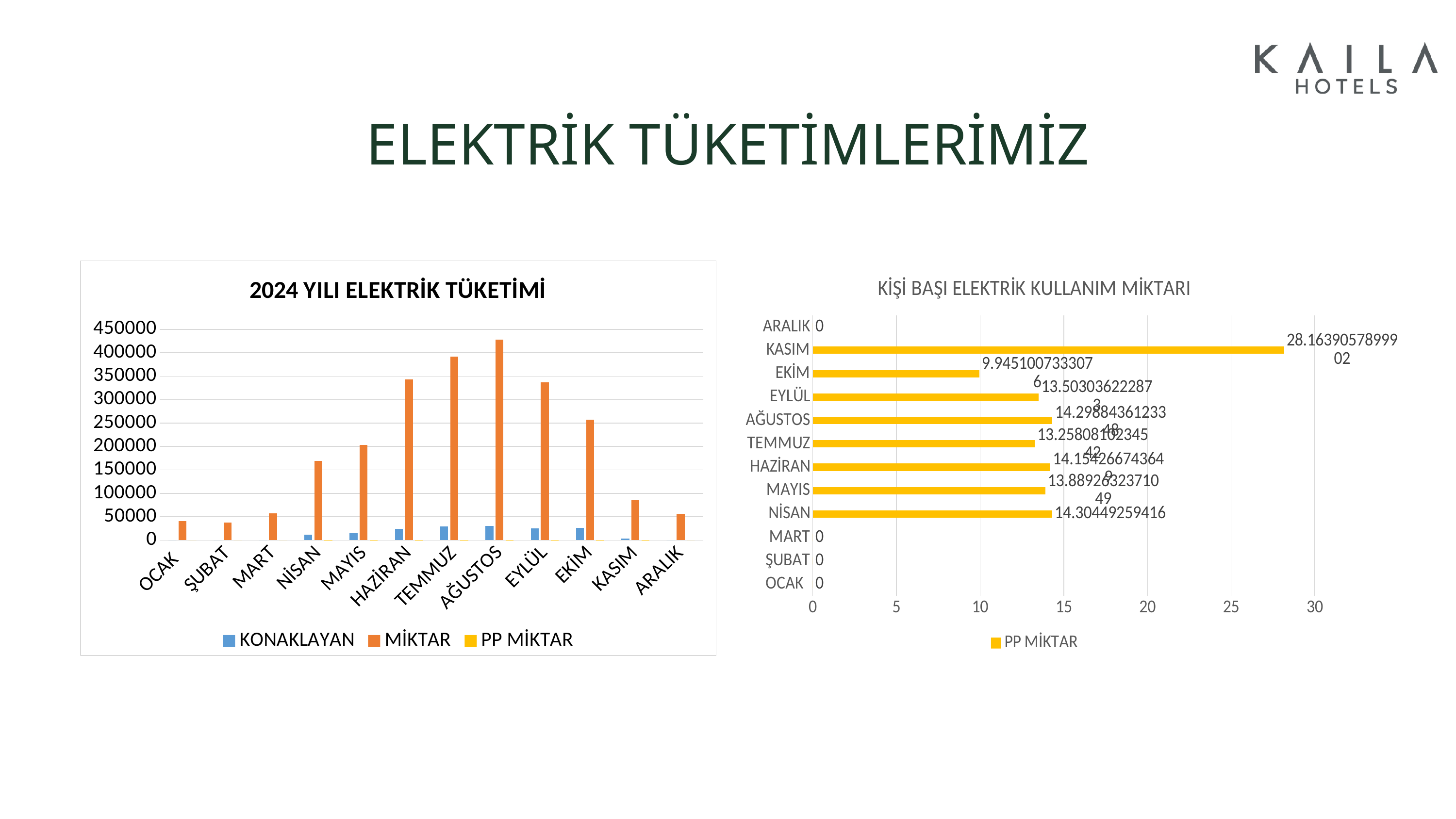
In the '2024 YILI ELEKTRİK TÜKETİMİ' chart, which month has the highest MİKTAR value? AĞUSTOS In the 'KİŞİ BAŞI ELEKTRİK KULLANIM MİKTARI' chart, which is larger, the value for KASIM or the value for EKİM? KASIM In the '2024 YILI ELEKTRİK TÜKETİMİ' chart, is the MİKTAR value for HAZİRAN greater or less than 300000? greater How many series does the legend of the '2024 YILI ELEKTRİK TÜKETİMİ' chart list? 3 In the 'KİŞİ BAŞI ELEKTRİK KULLANIM MİKTARI' chart, what is the PP MİKTAR value for ARALIK? 0 How many months are shown on the x axis of the '2024 YILI ELEKTRİK TÜKETİMİ' chart? 12 What kind of chart is the '2024 YILI ELEKTRİK TÜKETİMİ' chart on the left? bar chart In the '2024 YILI ELEKTRİK TÜKETİMİ' chart, does the MİKTAR series rise or fall from OCAK to AĞUSTOS? rise In the '2024 YILI ELEKTRİK TÜKETİMİ' chart, is the MİKTAR value for AĞUSTOS greater or less than 400000? greater In the 'KİŞİ BAŞI ELEKTRİK KULLANIM MİKTARI' chart, what is the PP MİKTAR value for NİSAN? 14.30449259416 In the 'KİŞİ BAŞI ELEKTRİK KULLANIM MİKTARI' chart, is the value for KASIM greater or less than 25? greater In the 'KİŞİ BAŞI ELEKTRİK KULLANIM MİKTARI' chart, which month has the highest PP MİKTAR value? KASIM